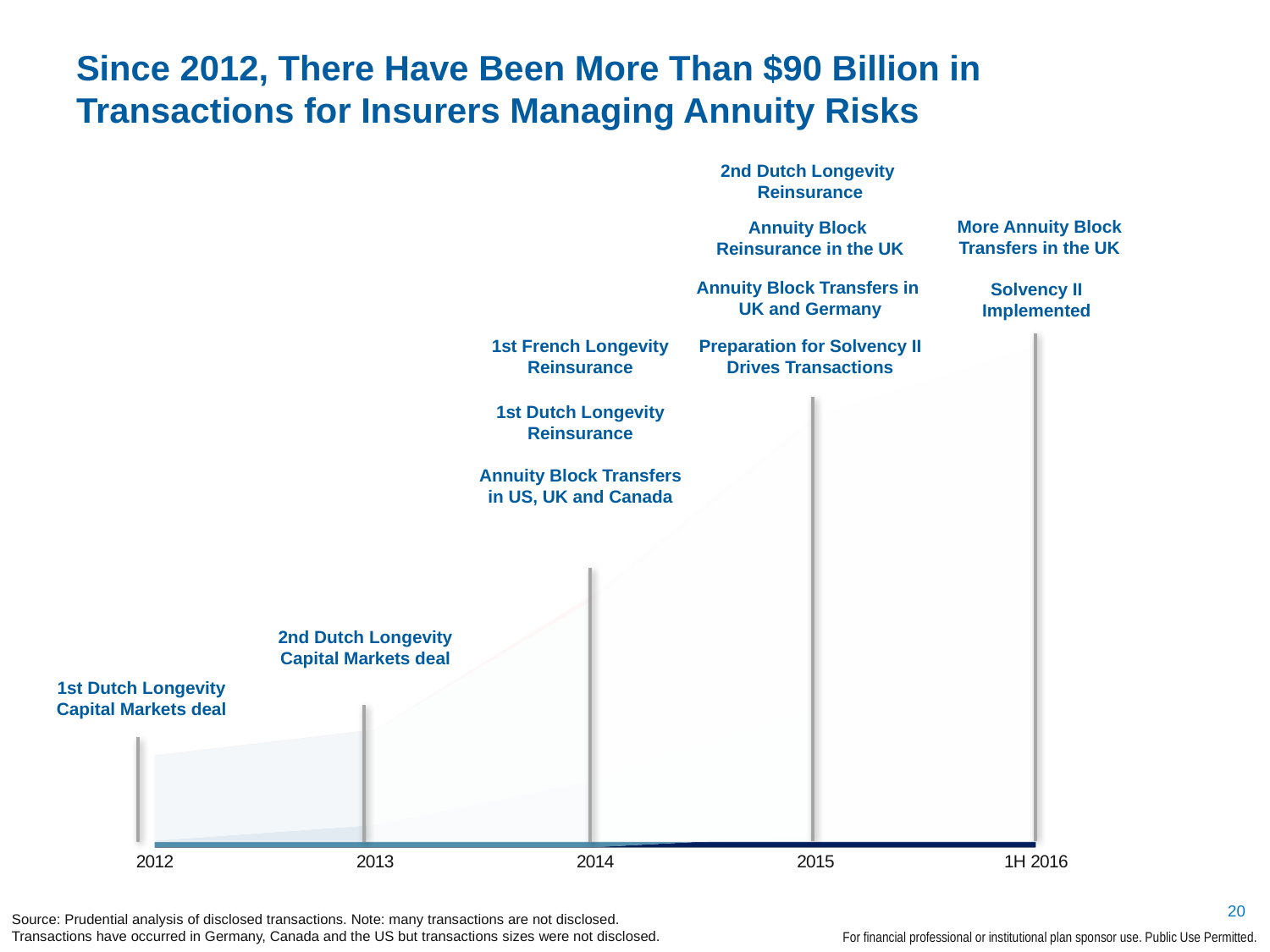
Which bar is taller, 2013 or 2015? 2015 Which bar is taller, 2014 or 2012? 2014 Under which x-axis period is the annotation '1st French Longevity Reinsurance' placed? 2014 How many time periods are labelled along the x axis of the chart? 5 Which period on the x axis has the tallest bar? 1H 2016 Under which x-axis period is the annotation 'Solvency II Implemented' placed? 1H 2016 Under which x-axis period is the annotation '2nd Dutch Longevity Capital Markets deal' placed? 2013 Do the bar heights rise or fall from 2012 to 1H 2016? rise Under which x-axis period is the annotation 'Preparation for Solvency II Drives Transactions' placed? 2015 What is the first period labelled on the x axis? 2012 What is the title of the chart on the slide? Since 2012, There Have Been More Than $90 Billion in Transactions for Insurers Managing Annuity Risks Which period on the x axis has the shortest bar? 2012